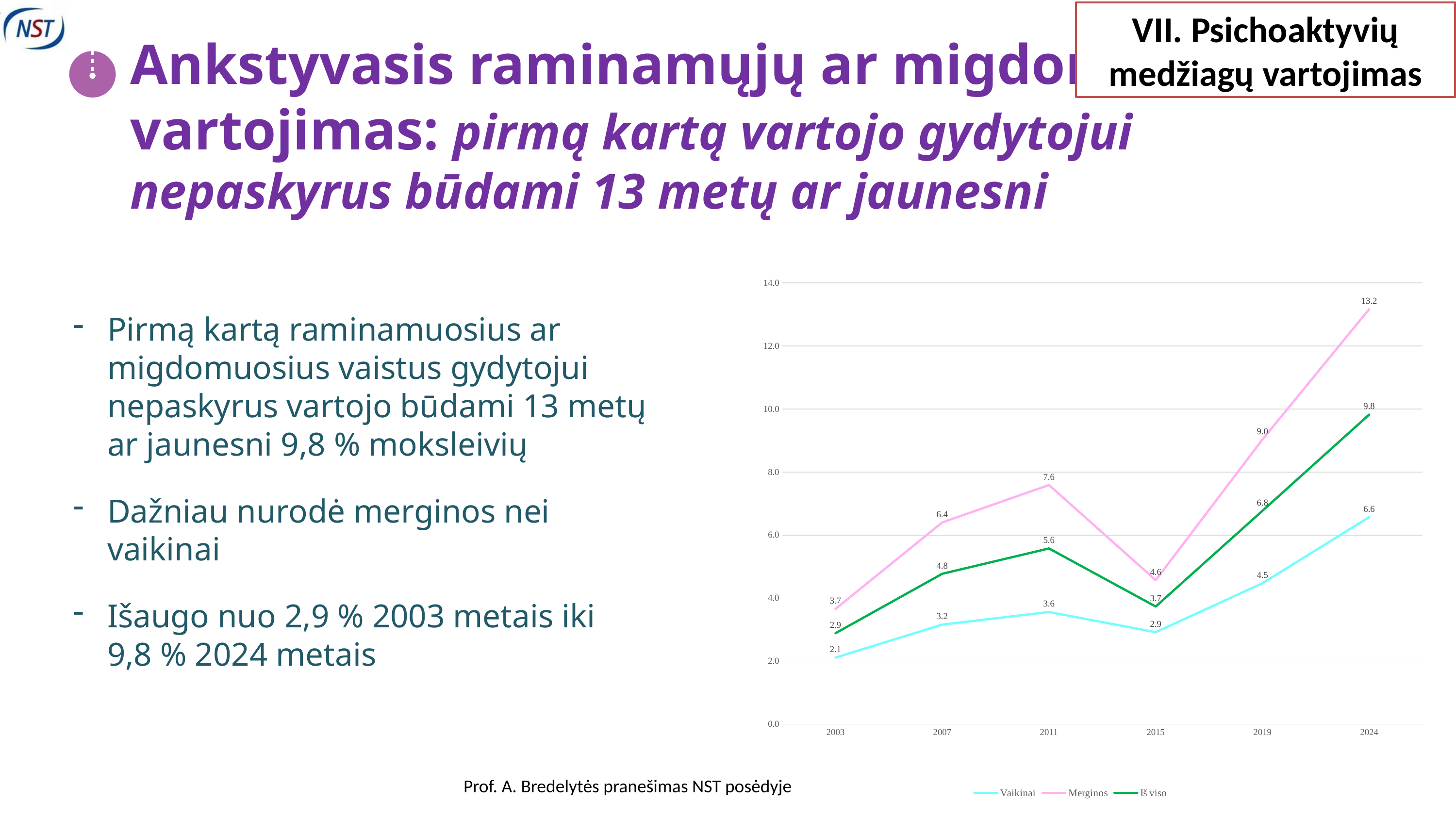
What kind of chart is shown on the slide? line chart In which year is the Vaikinai series at its lowest? 2003 What is the value for Merginos in 2024? 13.2 Is the value for Merginos in 2019 greater or less than 8.0? greater How many years are plotted along the x axis of the chart? 6 What is the difference between the Merginos and Vaikinai values in 2024? 6.6 What is the value for Iš viso in 2015? 3.7 Which series is drawn in pink in the chart? Merginos In which year is the Merginos series at its highest? 2024 Which is larger in 2011: the Merginos value or the Iš viso value? Merginos How many series does the chart legend list? 3 What is the value for Vaikinai in 2003? 2.1